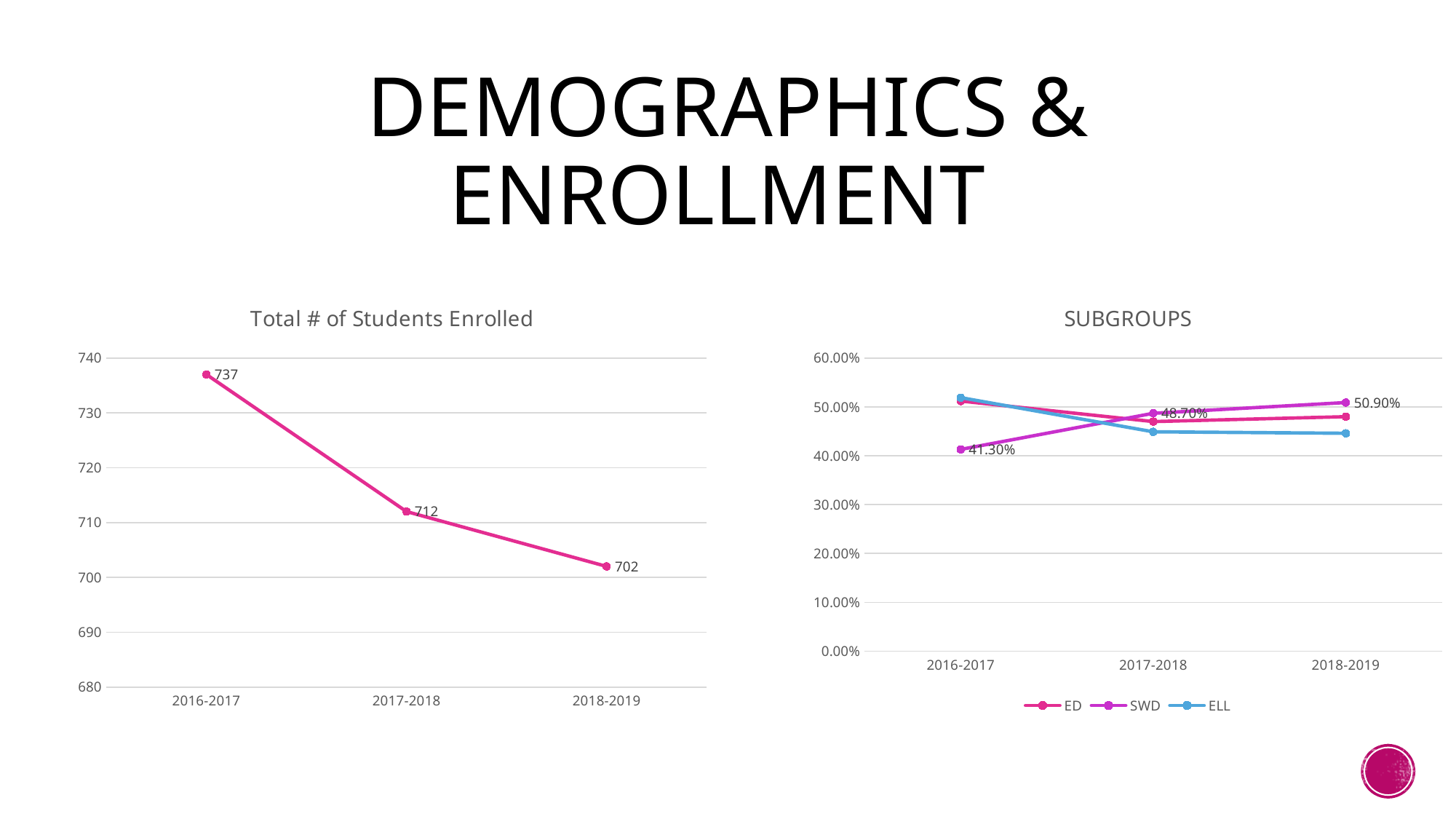
In the 'Total # of Students Enrolled' chart, by how much did enrollment drop from 2016-2017 to 2017-2018? 25 What kind of chart is the 'Total # of Students Enrolled' chart? line chart In the 'Total # of Students Enrolled' chart, how many school years are plotted? 3 In the 'Total # of Students Enrolled' chart, what was the total number of students enrolled in 2018-2019? 702 In the 'SUBGROUPS' chart, what was the SWD value in 2016-2017? 41.30% In the 'SUBGROUPS' chart, what was the SWD value in 2018-2019? 50.90% In the 'Total # of Students Enrolled' chart, what was the total number of students enrolled in 2016-2017? 737 In the 'Total # of Students Enrolled' chart, do the values rise or fall across the school years? fall In the 'SUBGROUPS' chart, how many series does the legend list? 3 In the 'SUBGROUPS' chart, is the ELL value for 2018-2019 greater or less than 50.00%? less In the 'Total # of Students Enrolled' chart, which school year had the lowest enrollment? 2018-2019 In the 'SUBGROUPS' chart, which series is shown in blue? ELL